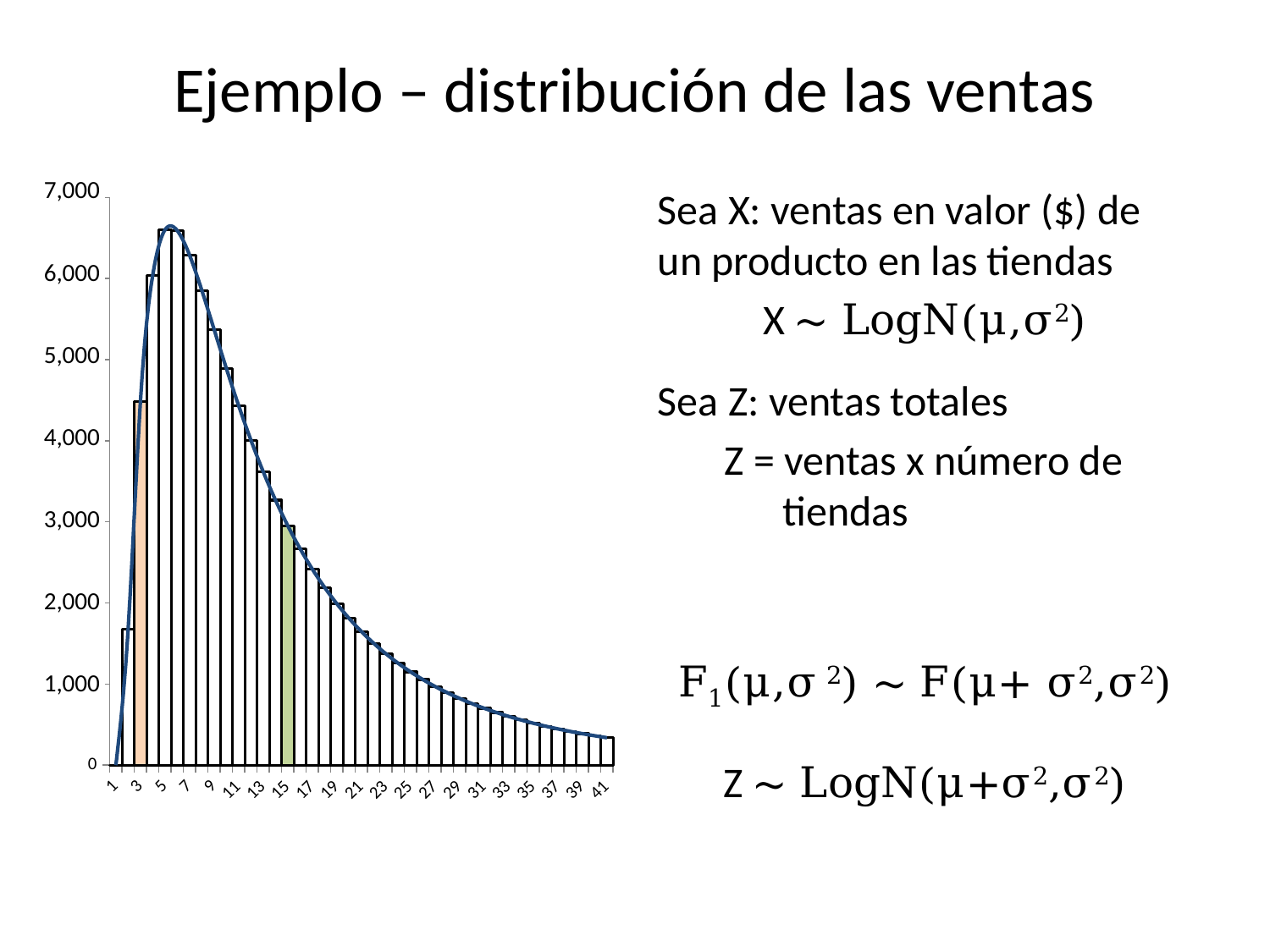
What kind of chart is shown on the slide? bar chart with a line overlay Which is larger, the bar at category 1 or the bar at category 3? category 3 What is the last category label shown on the x axis? 41 Is the value of the bar at category 3 greater or less than 5,000? less Do the bar values rise or fall along the x axis after the peak near category 5? fall Is the value of the green-shaded bar greater or less than 2,000? greater Is the value of the bar at category 41 greater or less than 1,000? less What is the highest value shown on the y axis? 7,000 Which is larger, the bar at category 5 or the bar at category 41? category 5